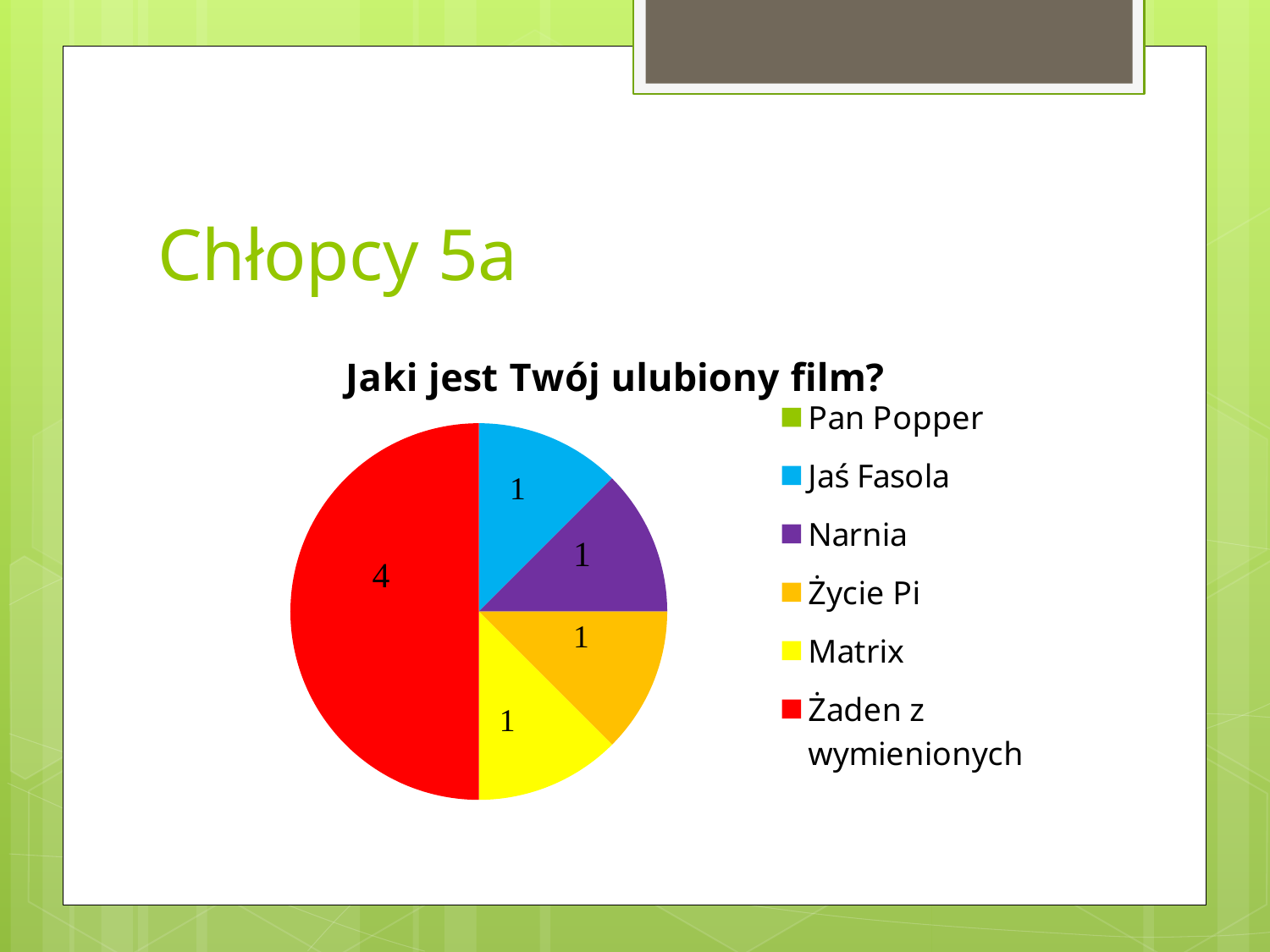
How many slices with data labels are visible in the pie chart? 5 What is the value shown for the "Żaden z wymienionych" slice of the pie chart? 4 What share of the pie does the "Żaden z wymienionych" slice represent? 50% What type of chart is shown on the slide? Pie chart What is the value shown for the "Jaś Fasola" slice of the pie chart? 1 What colour is the "Narnia" slice in the pie chart? Purple Which is larger: the value for "Żaden z wymienionych" or the value for "Życie Pi"? Żaden z wymienionych What is the difference between the value for "Żaden z wymienionych" and the value for "Narnia"? 3 What is the value shown for the "Matrix" slice of the pie chart? 1 Which category has the largest slice in the pie chart? Żaden z wymienionych How many entries does the chart legend list? 6 What is the title of the pie chart? Jaki jest Twój ulubiony film?